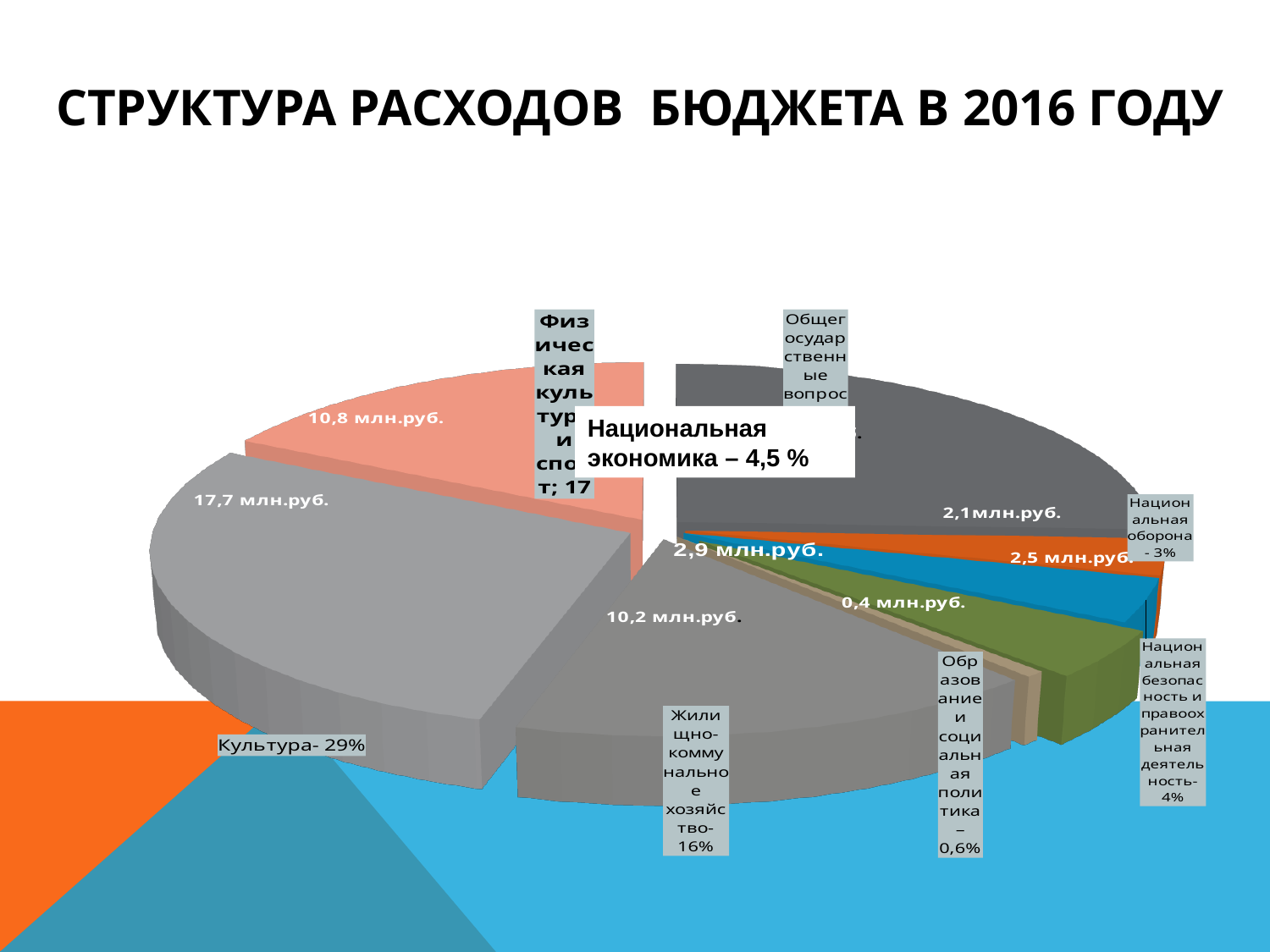
What share of the budget expenditure goes to Образование и социальная политика? 0,6% By how many percentage points does the share of Культура exceed that of Жилищно-коммунальное хозяйство? 13 Which category has the smallest share of the budget expenditure? Образование и социальная политика Which category has the largest share of the budget expenditure? Культура Which has a larger share: Культура or Жилищно-коммунальное хозяйство? Культура What share of the budget expenditure goes to Жилищно-коммунальное хозяйство? 16% What share of the budget expenditure goes to Культура? 29% What is the title of the slide's chart? СТРУКТУРА РАСХОДОВ БЮДЖЕТА В 2016 ГОДУ What kind of chart is shown on the slide? pie chart